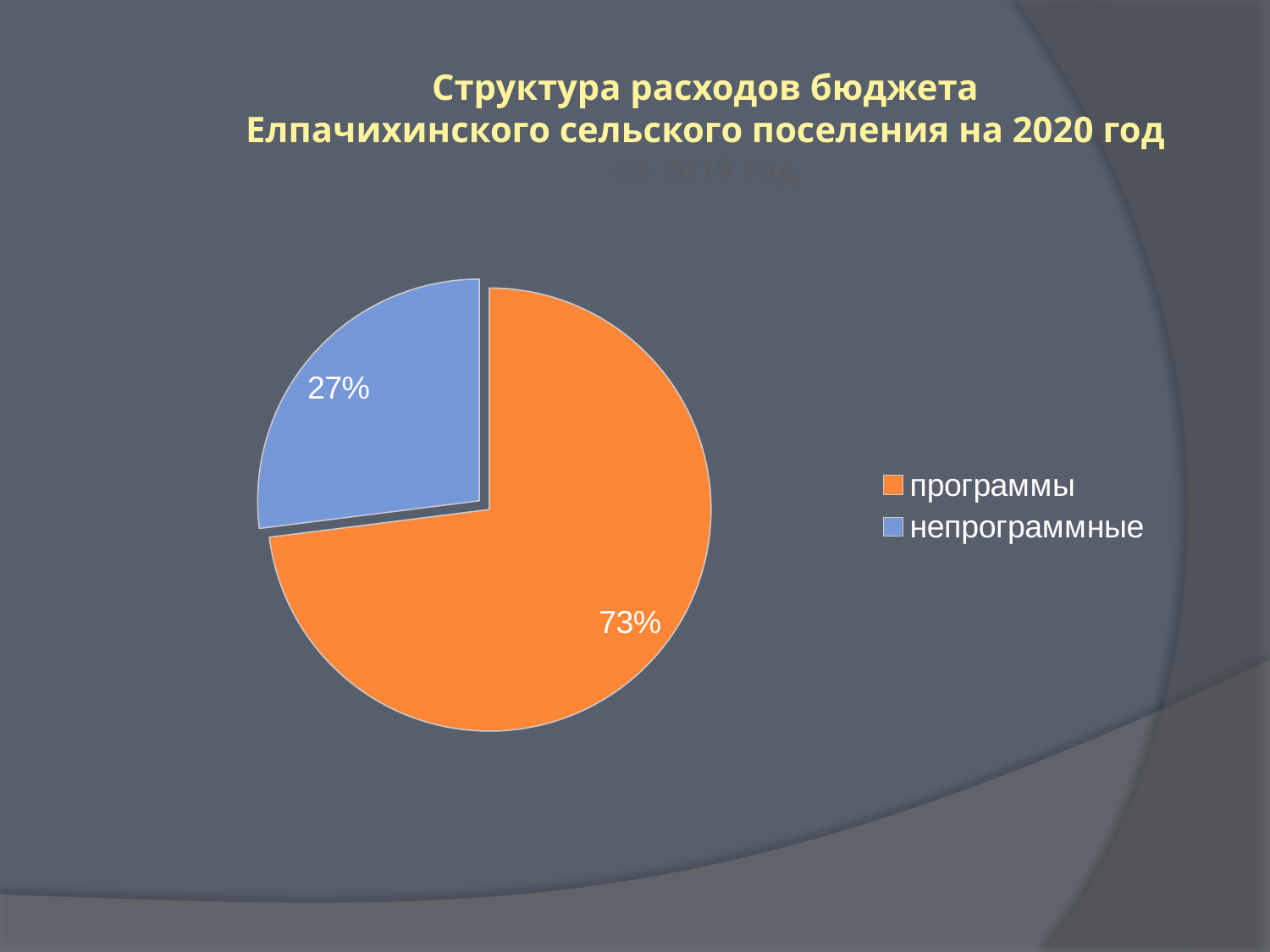
What share of the pie does the "непрограммные" slice represent? 27% What colour is the "программы" slice? orange How many slices does the pie chart have? 2 What colour is the "непрограммные" slice? blue How many entries does the legend list? 2 What share of the pie does the "программы" slice represent? 73% What is the difference in percentage points between the "программы" and "непрограммные" slices? 46 Which category has the smallest share of the pie? непрограммные Which is larger: the share for "программы" or the share for "непрограммные"? программы What kind of chart is shown on the slide? pie chart Which category has the largest share of the pie? программы